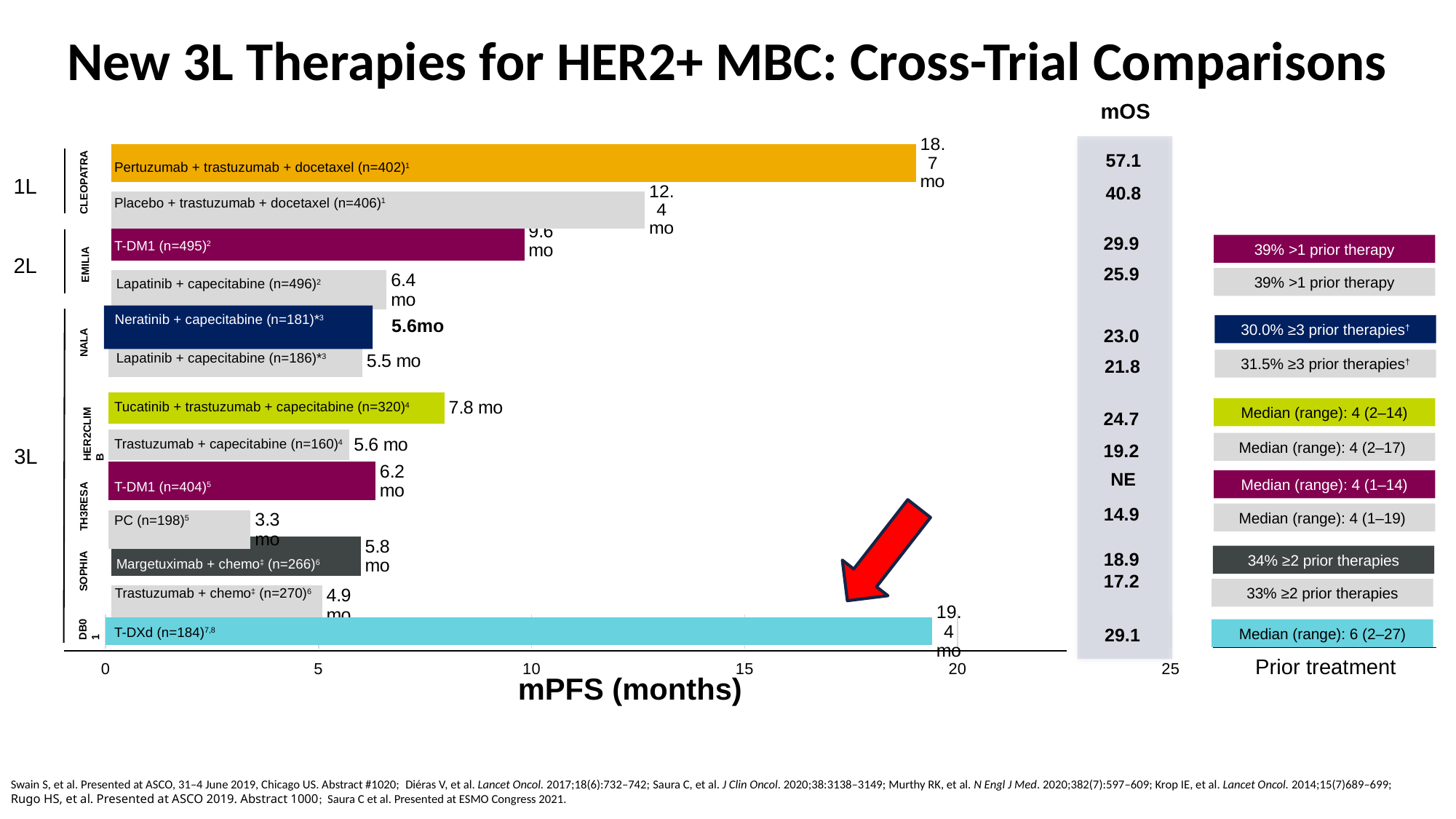
What kind of chart is used to show mPFS on this slide? Bar chart What is the mPFS value shown for T-DXd (n=184)? 19.4 mo What is the difference in mPFS between T-DM1 (n=495) and Lapatinib + capecitabine (n=496)? 3.2 mo How many therapy bars are plotted on the chart? 13 What is the label of the x axis of the chart? mPFS (months) Which therapy has the highest mPFS on the chart? T-DXd (n=184) Which therapy has the lowest mPFS on the chart? PC (n=198) Is the mPFS value for Placebo + trastuzumab + docetaxel (n=406) greater or less than 10 months? greater What is the mPFS value shown for Pertuzumab + trastuzumab + docetaxel (n=402)? 18.7 mo What is the mPFS value shown for Tucatinib + trastuzumab + capecitabine (n=320)? 7.8 mo Which has the larger mPFS: Margetuximab + chemo (n=266) or Trastuzumab + chemo (n=270)? Margetuximab + chemo (n=266) What is the mOS value listed for T-DXd (n=184)? 29.1